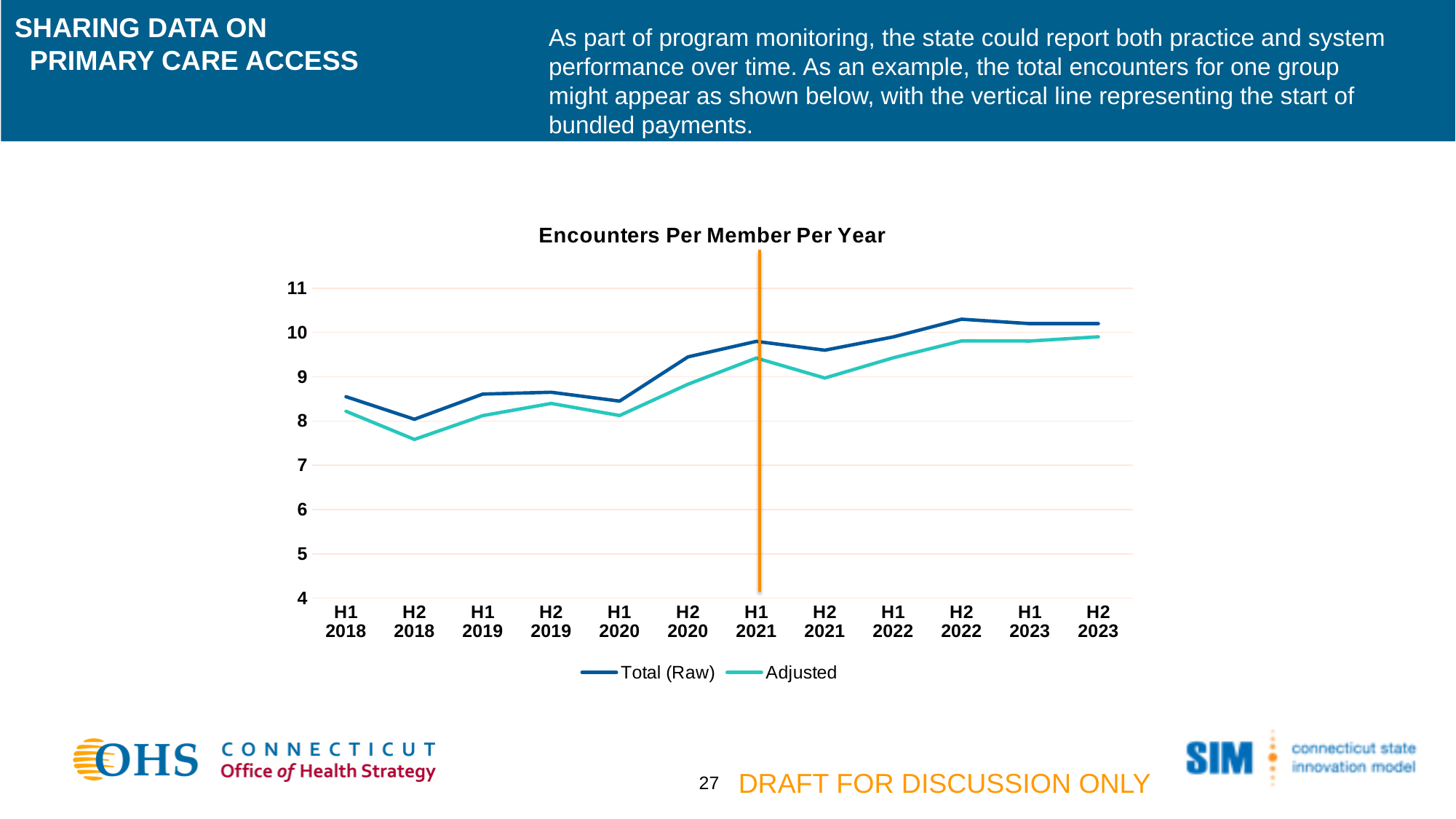
How many time periods are plotted along the x axis? 12 How many series does the legend list? 2 What is the title of the chart? Encounters Per Member Per Year What are the two series named in the legend? Total (Raw) and Adjusted What kind of chart is shown on the slide? Line chart Which series has the larger value in H2 2018, Total (Raw) or Adjusted? Total (Raw) In which period is the Total (Raw) series at its highest? H2 2022 Is the Adjusted value for H2 2018 greater or less than 8? less In which period is the Total (Raw) series at its lowest? H2 2018 Is the Total (Raw) value for H2 2022 greater or less than 10? greater In which period is the Adjusted series at its lowest? H2 2018 Is the Total (Raw) value for H1 2018 greater or less than 9? less